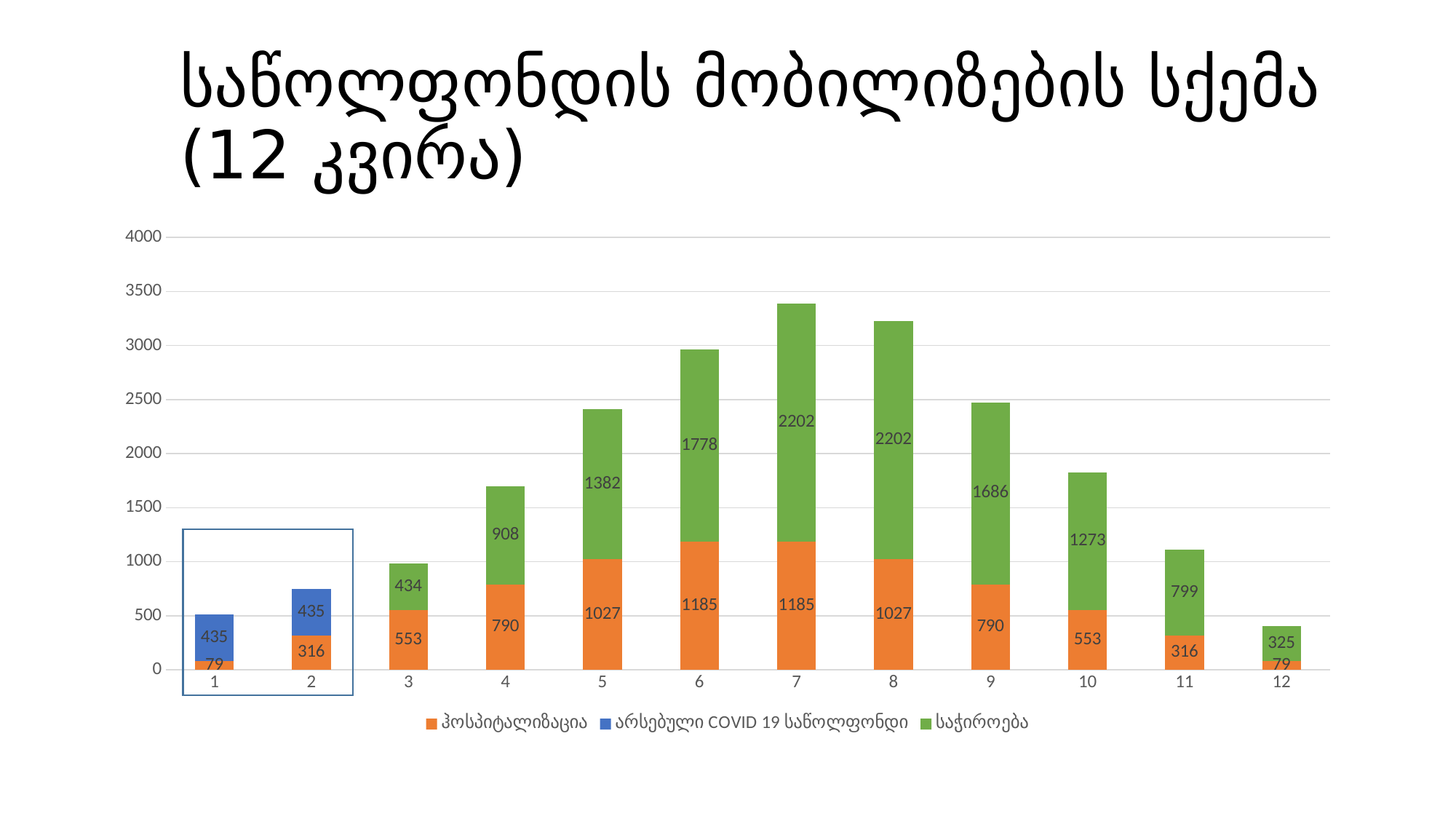
What is the difference between the საჭიროება values for week 6 and week 4? 870 Which week has the tallest stacked bar? 7 What is the value of the საჭიროება (green) segment for week 9? 1686 Is the ჰოსპიტალიზაცია value for week 6 larger or smaller than the value for week 10? larger How many series does the legend list? 3 What is the value of the ჰოსპიტალიზაცია (orange) segment for week 5? 1027 What is the value of the არსებული COVID 19 საწოლფონდი (blue) segment for week 2? 435 What type of chart is shown on the slide? stacked bar chart How many categories (weeks) are shown on the x axis? 12 What is the total of the stacked bar for week 7? 3387 Is the total stacked bar for week 8 greater or less than 3000? greater Which week has the shortest stacked bar? 12